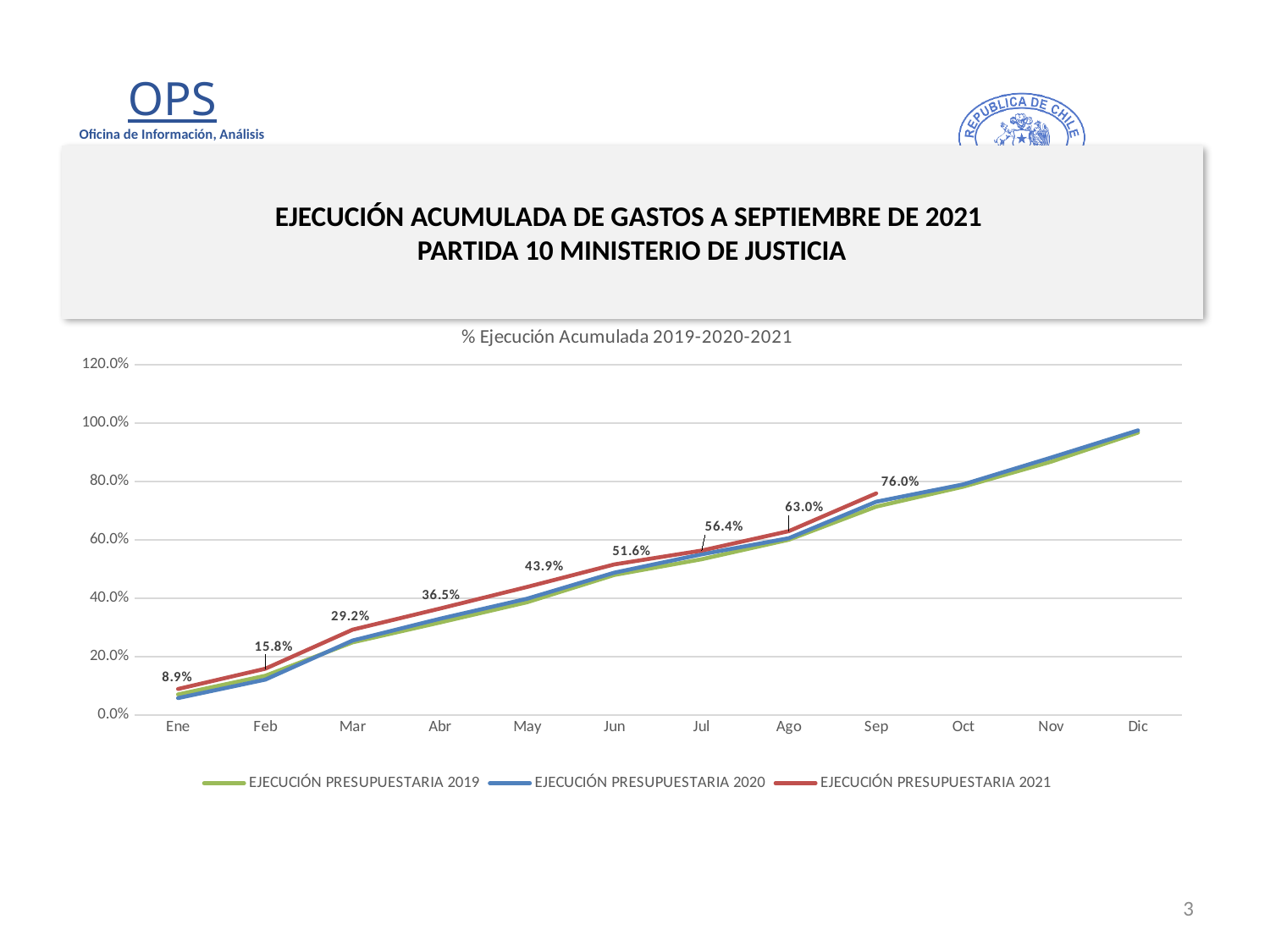
What is the value for EJECUCIÓN PRESUPUESTARIA 2021 in Ene? 8.9% What is the difference between the 2021 values for Sep and Ago? 13.0% How many months are shown on the x axis? 12 What is the value for EJECUCIÓN PRESUPUESTARIA 2021 in May? 43.9% What is the title of the chart? % Ejecución Acumulada 2019-2020-2021 What is the difference between the 2021 values for Mar and Feb? 13.4% How many series does the legend list? 3 What is the value for EJECUCIÓN PRESUPUESTARIA 2021 in Sep? 76.0% Is the value for EJECUCIÓN PRESUPUESTARIA 2020 in Dic greater or less than 80.0%? greater What is the value for EJECUCIÓN PRESUPUESTARIA 2021 in Ago? 63.0% What type of chart is shown on the slide? line chart Do the values for EJECUCIÓN PRESUPUESTARIA 2021 rise or fall from Ene to Sep? rise